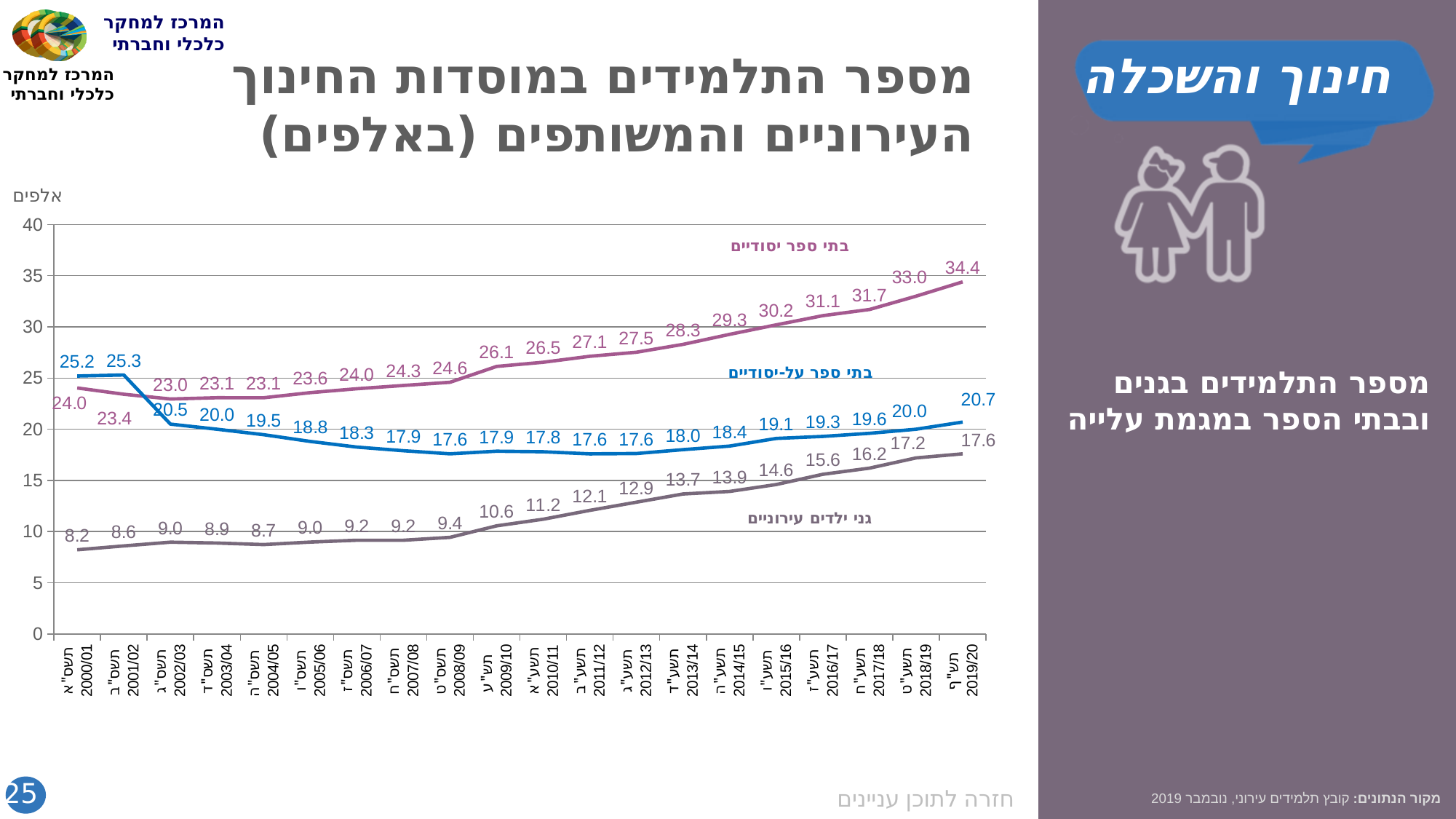
In which school year is the value for בתי ספר יסודיים the highest? 2019/20 What type of chart is shown on the slide? Line chart Does the value for גני ילדים עירוניים rise or fall from 2008/09 to 2019/20? Rise In which school year is the value for גני ילדים עירוניים the lowest? 2000/01 What unit label is shown above the y-axis of the chart? אלפים What is the value for בתי ספר יסודיים in 2019/20? 34.4 How many series are plotted on the chart? 3 What is the value for גני ילדים עירוניים in 2012/13? 12.9 Which series has the larger value in 2000/01: בתי ספר יסודיים or בתי ספר על-יסודיים? בתי ספר על-יסודיים What is the difference between the בתי ספר יסודיים value in 2019/20 and in 2000/01? 10.4 How many school years (x-axis points) are shown on the chart? 20 What is the value for בתי ספר על-יסודיים in 2000/01? 25.2